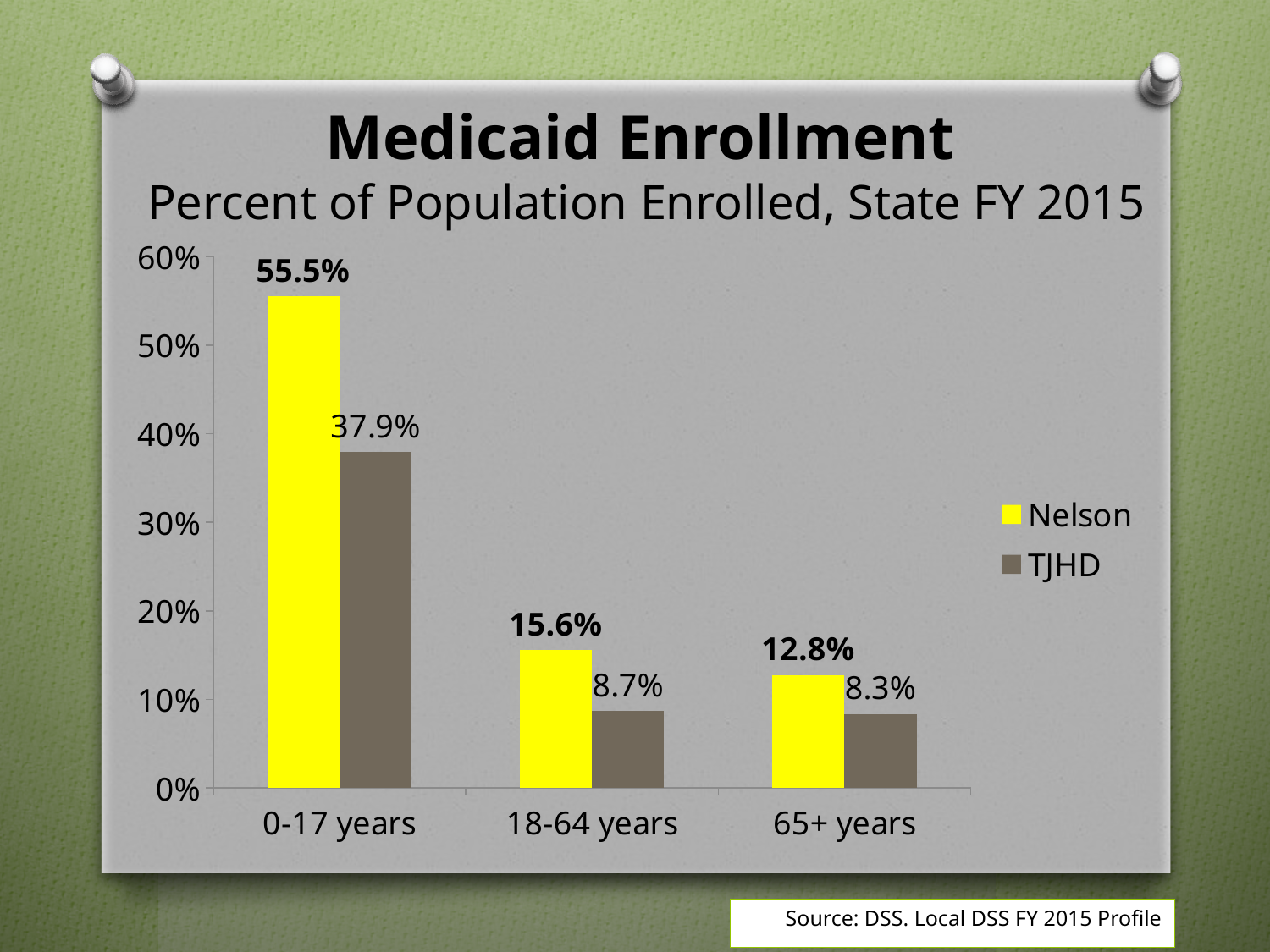
How many age groups are shown on the x axis? 3 Which age group has the lowest Medicaid enrollment percentage for TJHD? 65+ years What kind of chart is shown on the slide? Bar chart Which is larger for the 18-64 years age group, the Nelson value or the TJHD value? Nelson What is the Nelson value for the 65+ years age group? 12.8% How many series does the legend list? 2 Which age group has the highest Medicaid enrollment percentage for Nelson? 0-17 years What is the difference between the Nelson and TJHD values for the 0-17 years age group? 17.6% What is the TJHD value for the 18-64 years age group? 8.7% Do the Nelson values rise or fall from the 0-17 years group to the 65+ years group? Fall What percent of the 0-17 years population is enrolled in Medicaid for Nelson? 55.5% What is the TJHD value for the 0-17 years age group? 37.9%